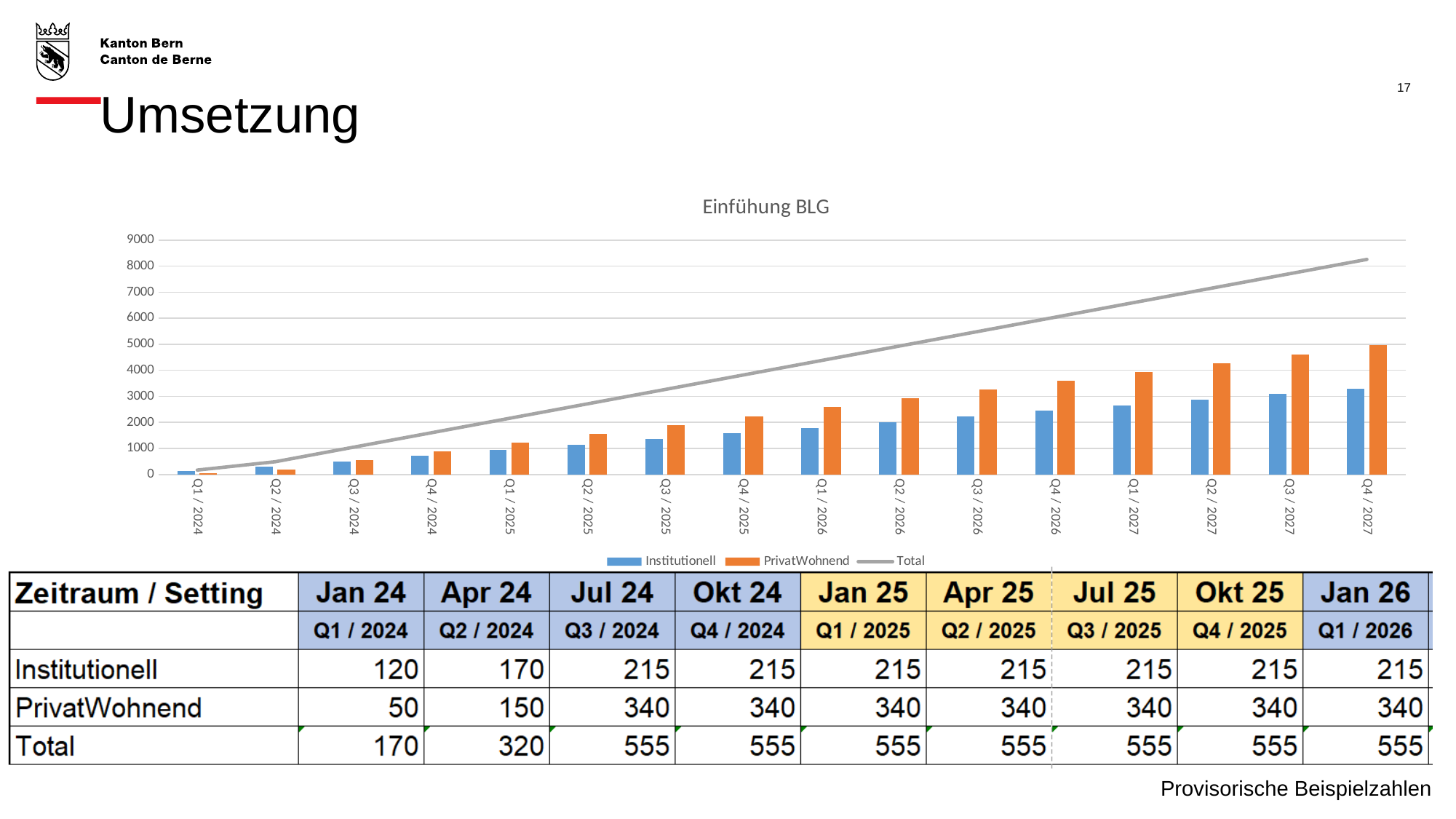
What is the title of the chart? Einfühung BLG Which bar is the highest in the chart? PrivatWohnend in Q4 / 2027 In Q1 / 2024, which is larger: the Institutionell bar or the PrivatWohnend bar? Institutionell Which series is drawn as a grey line in the chart? Total How many series does the chart legend list? 3 Is the value of the Total line at Q4 / 2027 greater or less than 8000? greater In Q4 / 2027, which is larger: the Institutionell bar or the PrivatWohnend bar? PrivatWohnend Is the Institutionell value for Q4 / 2027 greater or less than 3000? greater How many quarters are shown on the x axis of the chart? 16 What kind of chart is shown on the slide? A bar chart combined with a line Do the values of the Total line rise or fall from Q1 / 2024 to Q4 / 2027? Rise